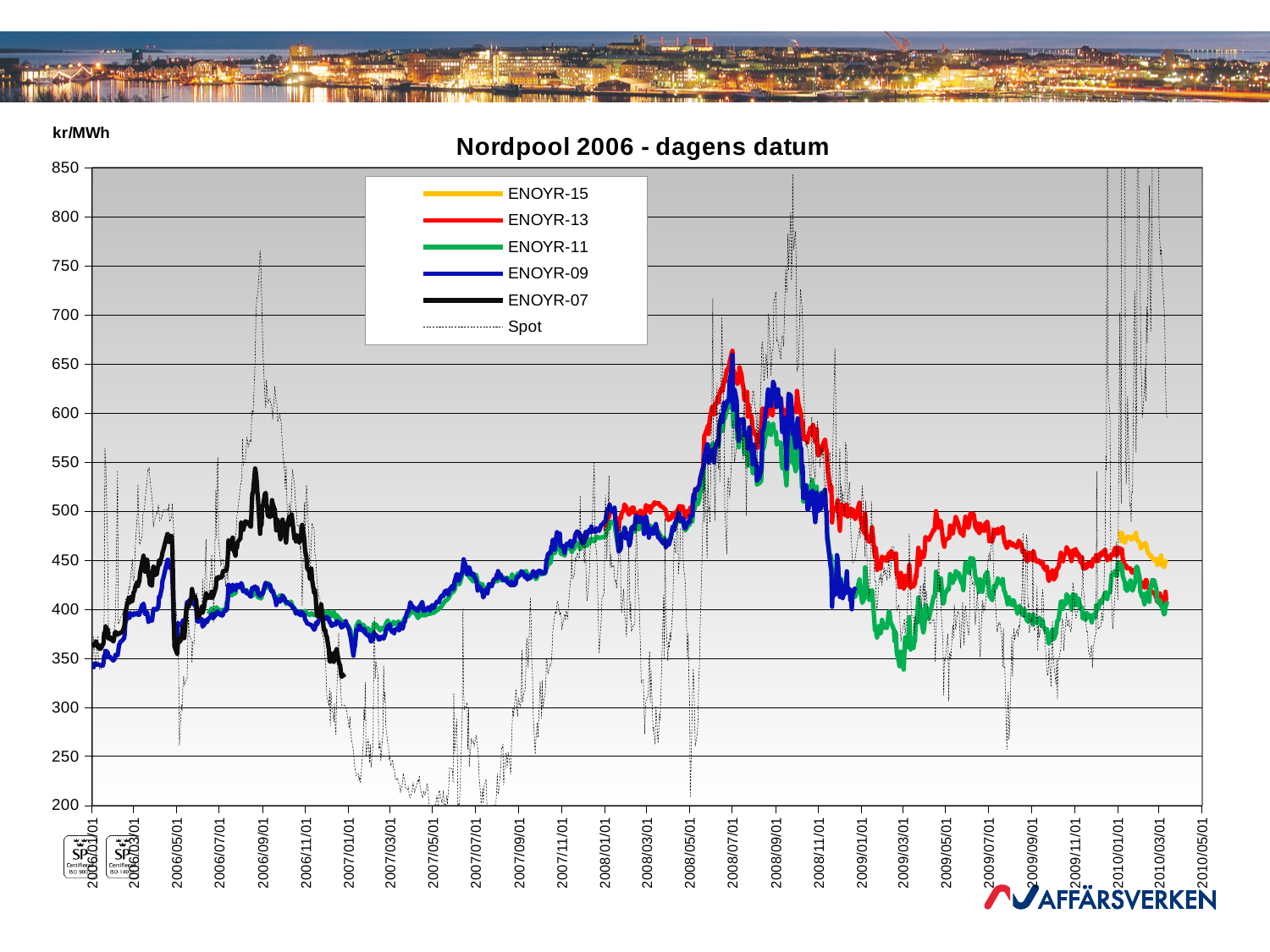
How many series does the legend list? 6 Is the peak value of the Spot series around 2008/09/01 greater or less than 700? greater Does ENOYR-09 rise or fall between 2007/05/01 and 2008/07/01? rise What kind of chart is shown on the slide? line chart Is the peak value of ENOYR-07 around 2006/09/01 greater or less than 500? greater Is the lowest value of ENOYR-11 around 2009/03/01 greater or less than 400? less Around 2009/07/01, which series has the higher value, ENOYR-13 or ENOYR-11? ENOYR-13 What is the title of the chart? Nordpool 2006 - dagens datum What unit is shown on the y axis of the chart? kr/MWh Does ENOYR-07 rise or fall between 2006/09/01 and 2007/01/01? fall